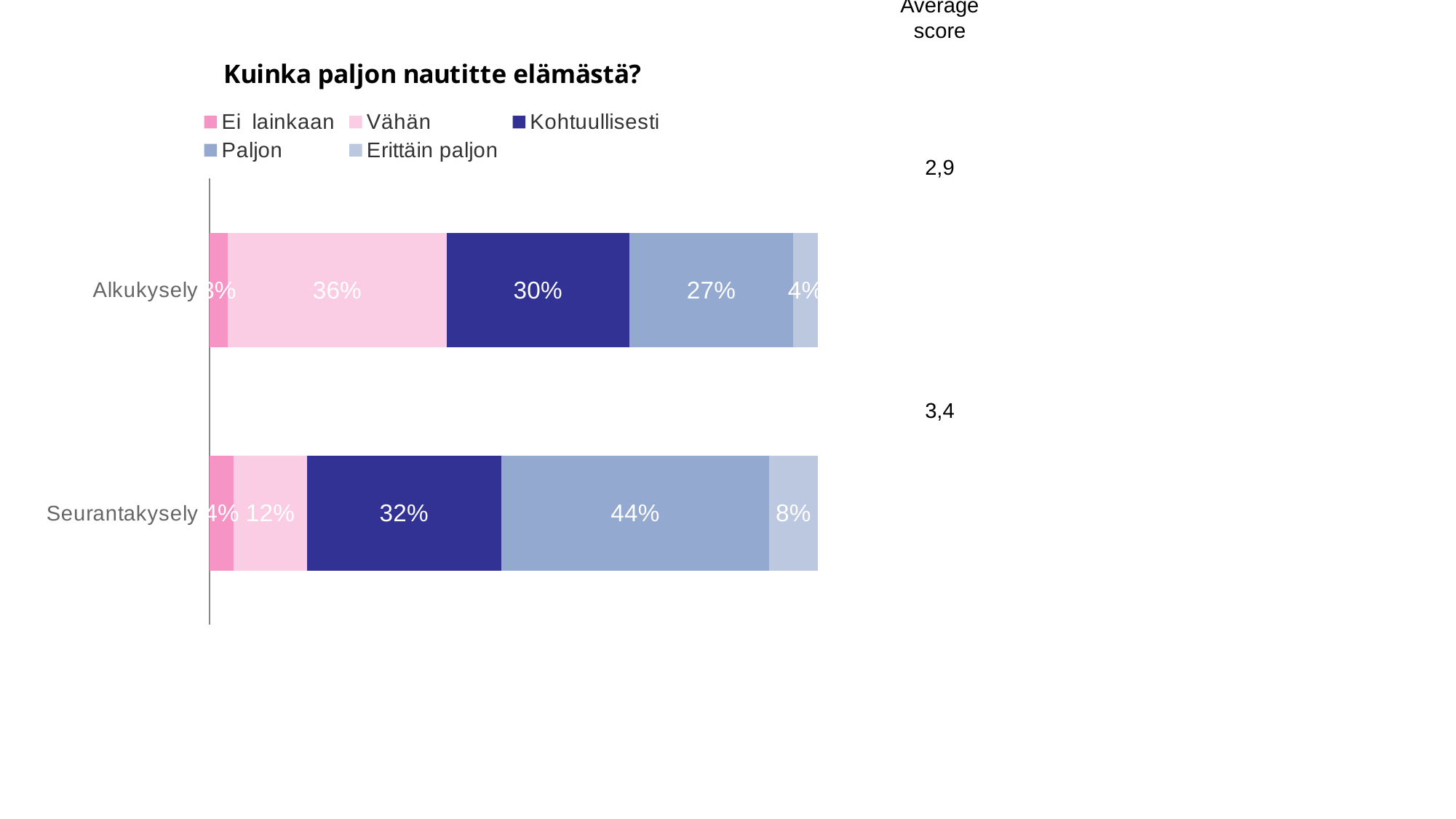
What percentage of Alkukysely respondents answered Vähän? 36% Which response has the largest share in the Alkukysely bar? Vähän How many response categories does the legend list? 5 What is the value for Paljon in the Alkukysely bar? 27% What is the value for Erittäin paljon in the Seurantakysely bar? 8% Which response has the largest share in the Seurantakysely bar? Paljon How many bars (survey rounds) are shown in the chart? 2 What is the title of the chart? Kuinka paljon nautitte elämästä? What percentage of Seurantakysely respondents answered Kohtuullisesti? 32% Which survey has the larger Vähän share, Alkukysely or Seurantakysely? Alkukysely By how many percentage points is the Paljon share higher in Seurantakysely than in Alkukysely? 17 percentage points What kind of chart is shown on the slide? Stacked bar chart